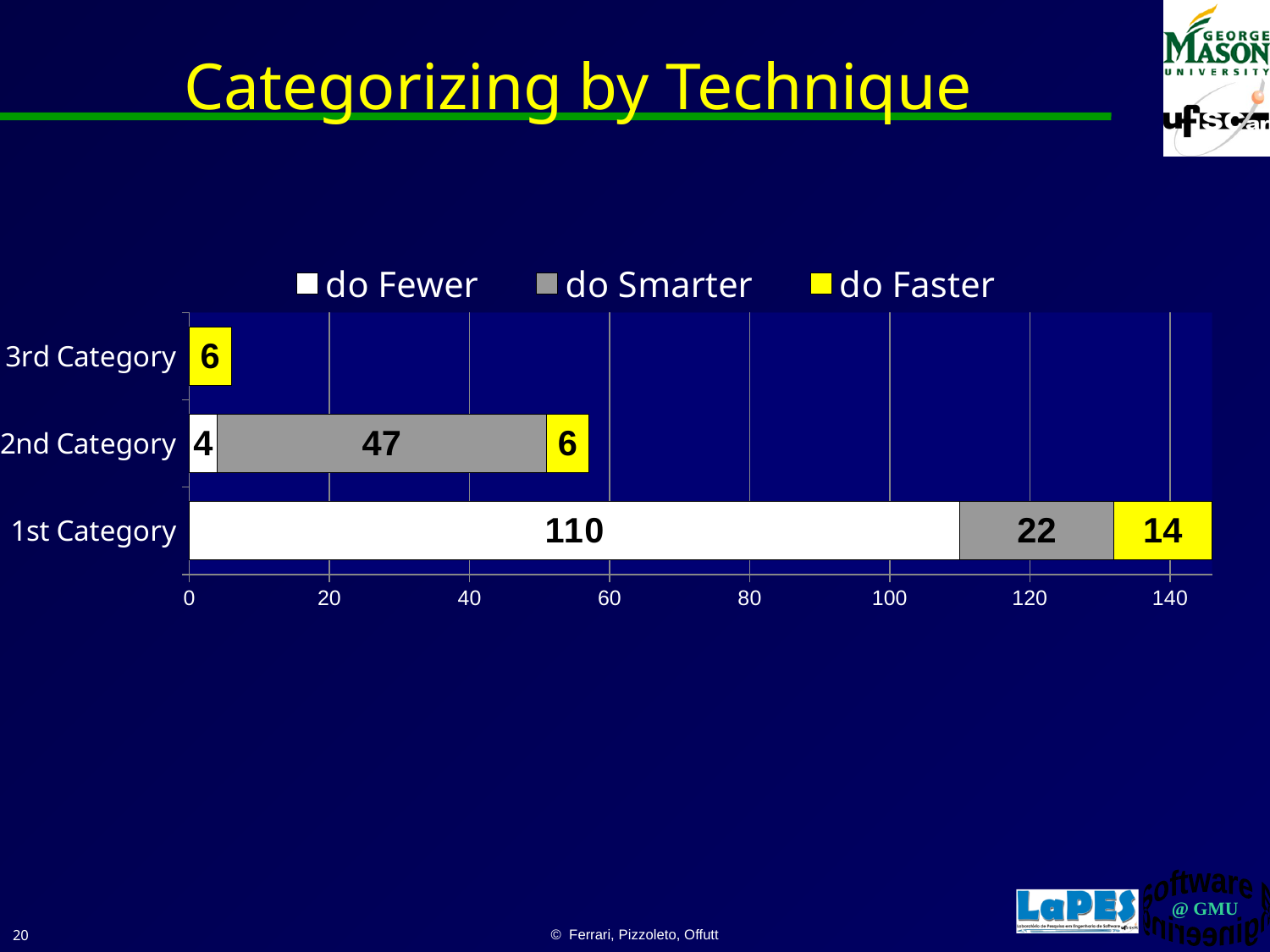
What is the value of do Smarter for 2nd Category? 47 What is the total of the stacked bar for 1st Category? 146 What is the total of the stacked bar for 2nd Category? 57 Which category has the longest stacked bar? 1st Category How many categories are shown on the y axis? 3 What is the difference between do Smarter for 2nd Category and do Smarter for 1st Category? 25 What is the value of do Faster for 3rd Category? 6 What is the value of do Fewer for 1st Category? 110 Which is larger: do Faster for 1st Category or do Faster for 2nd Category? do Faster for 1st Category What is the value of do Faster for 1st Category? 14 What kind of chart is shown on the slide? stacked bar chart How many series does the legend list? 3